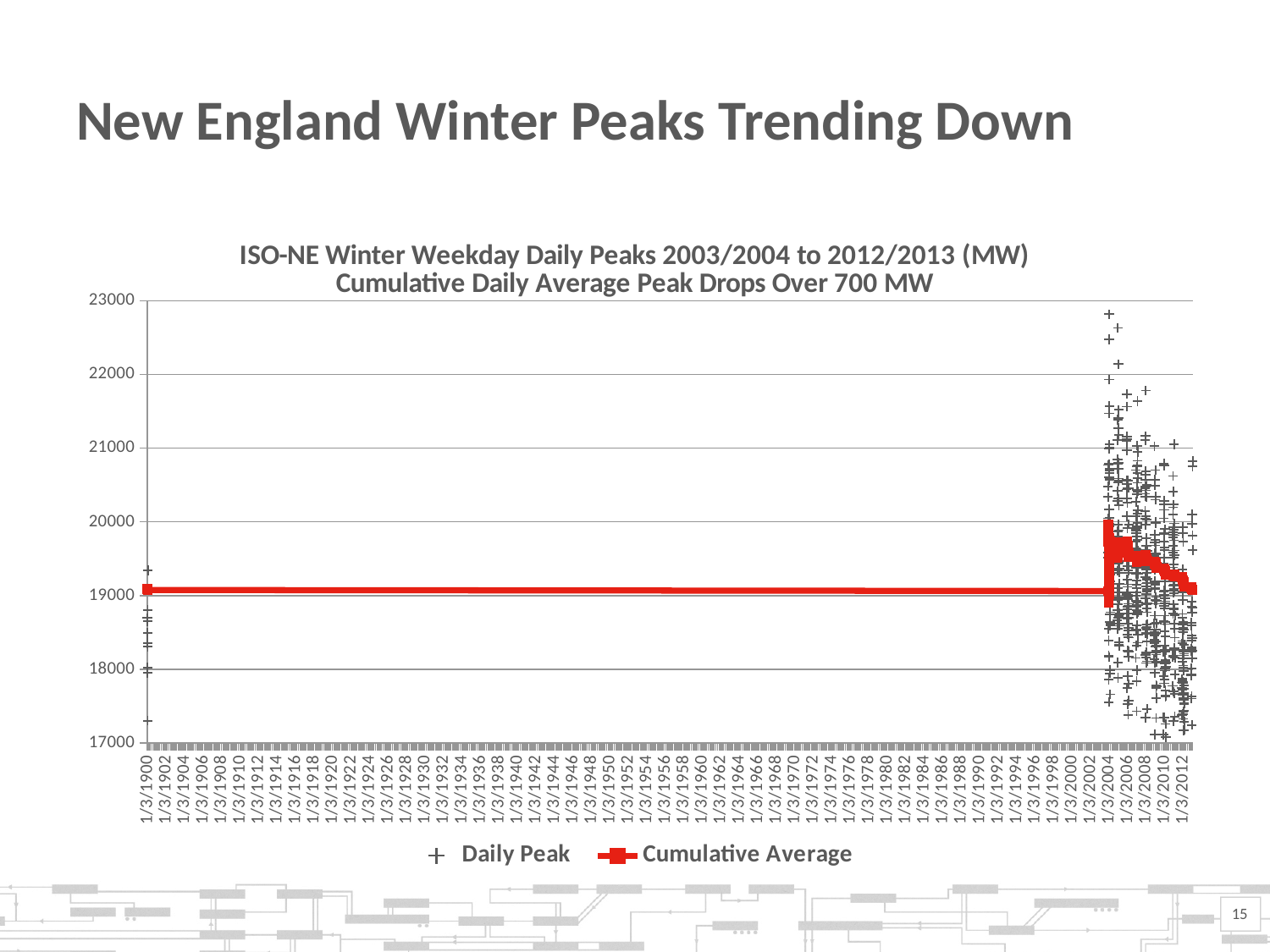
What is the maximum value shown on the vertical axis? 23000 What kind of chart is shown on the slide? Scatter chart with a line What are the two series named in the legend? Daily Peak and Cumulative Average Is the Cumulative Average value at the start of the 2004 data greater or less than 19000? greater By how much does the chart title say the cumulative daily average peak drops? Over 700 MW Is the lowest Daily Peak value plotted greater or less than 18000? less Which series is drawn in red? Cumulative Average Does the Cumulative Average series rise or fall across the 2004 to 2013 period? Fall Is the highest Daily Peak value plotted greater or less than 22000? greater How many series does the chart legend list? 2